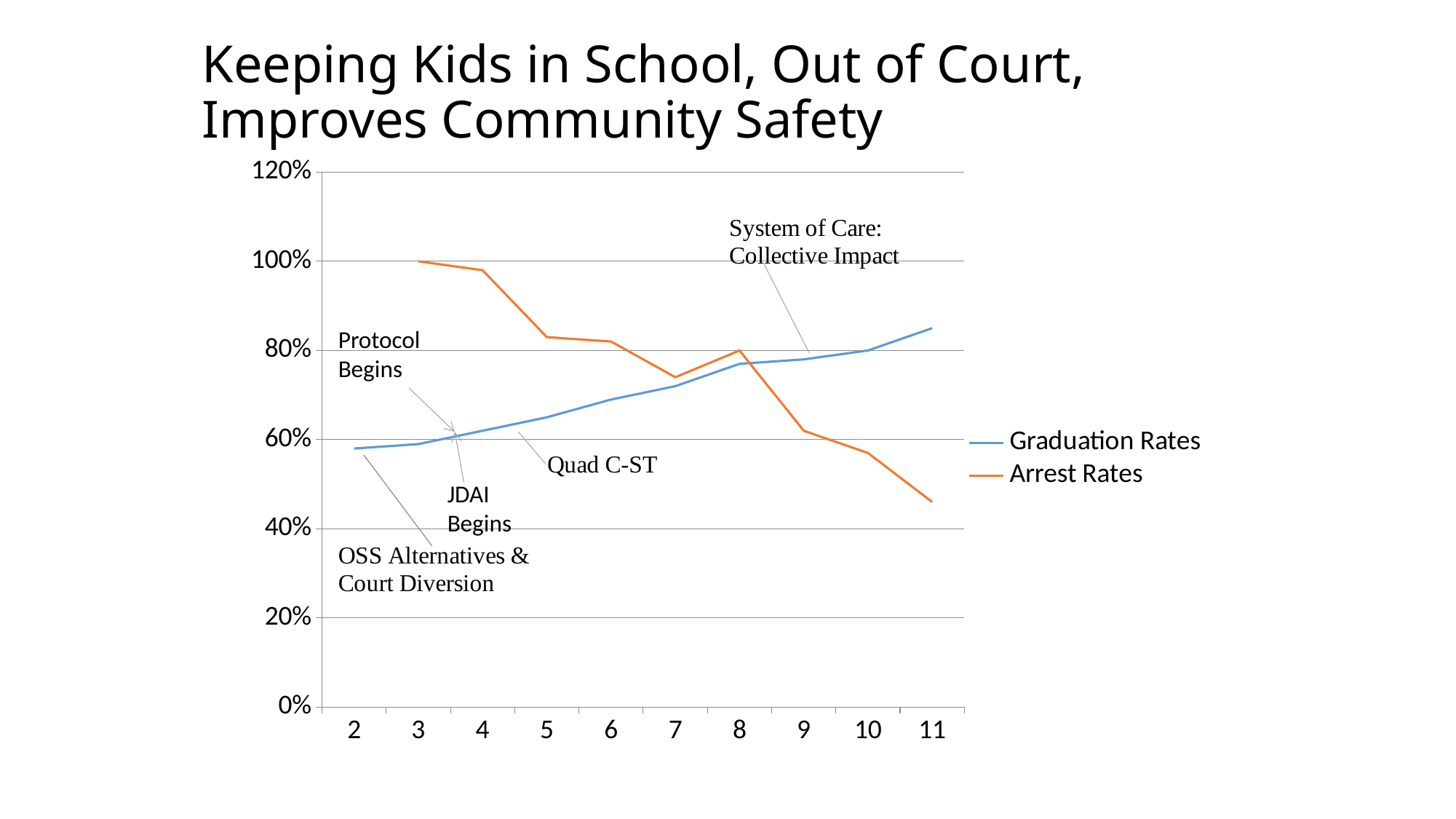
Do the Graduation Rates rise or fall from left to right along the x axis? Rise What kind of chart is shown on the slide? Line chart What are the two series named in the legend? Graduation Rates and Arrest Rates Is the Arrest Rates value at x-axis value 11 greater or less than 60%? less Do the Arrest Rates rise or fall from left to right along the x axis? Fall At which x-axis value is the Graduation Rates series lowest? 2 At which x-axis value is the Arrest Rates series highest? 3 How many x-axis categories are shown on the chart? 10 How many series does the legend list? 2 At x-axis value 11, which series has the larger value, Graduation Rates or Arrest Rates? Graduation Rates Is the Graduation Rates value at x-axis value 11 greater or less than 80%? greater At which x-axis value is the Arrest Rates series lowest? 11